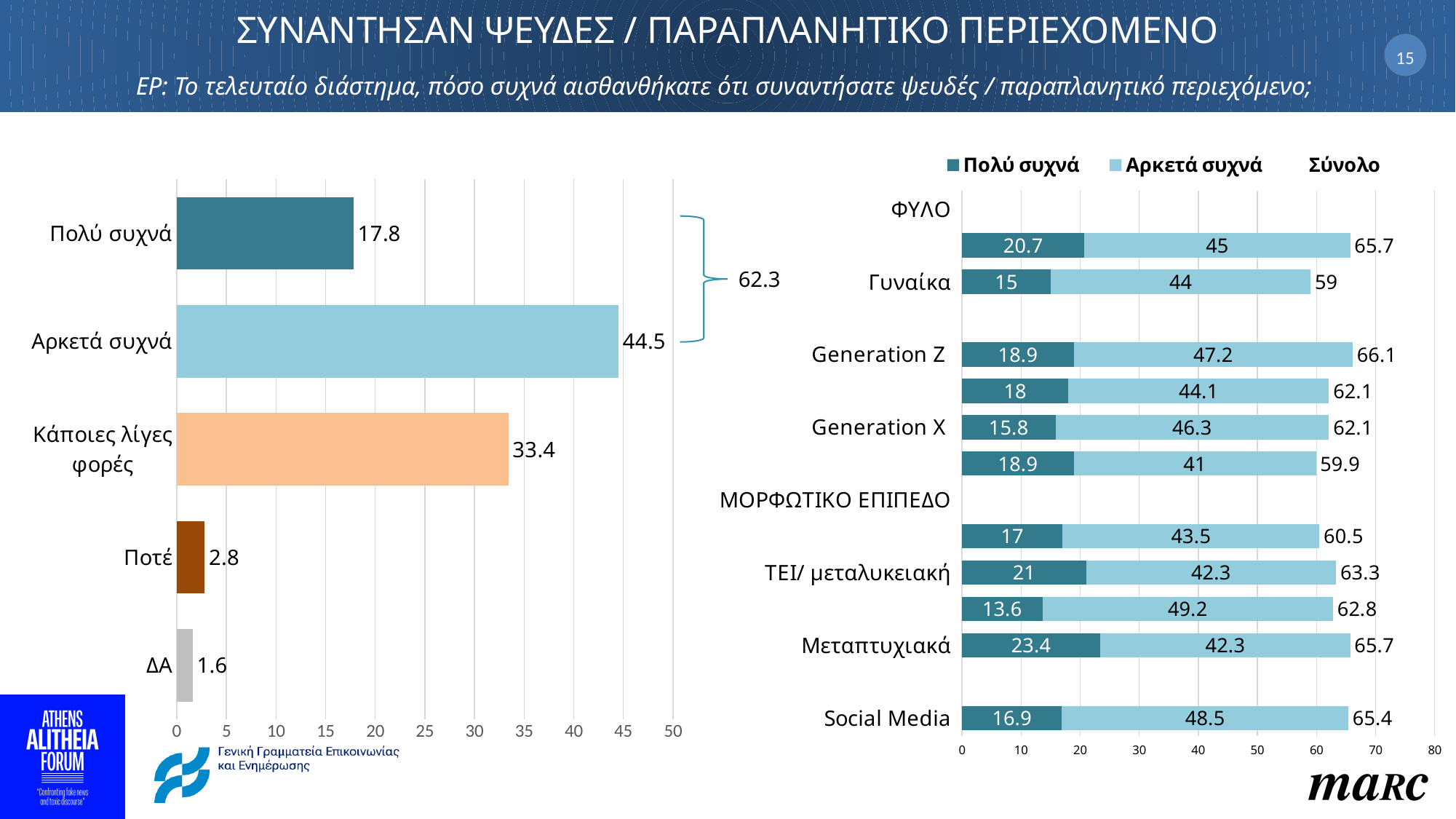
In the left chart, which category has the lowest value? ΔΑ In the right chart, what is the total (Σύνολο) for Generation Z? 66.1 In the left chart, which category has the highest value? Αρκετά συχνά In the left chart, how many categories are shown? 5 How many series does the legend of the right chart list? 3 What type of chart is the left chart? Bar chart In the right chart, which is larger: the Πολύ συχνά value for Γυναίκα or for Generation X? Generation X In the left chart, what is the difference between Αρκετά συχνά and Κάποιες λίγες φορές? 11.1 In the right chart, what is the Αρκετά συχνά value for Social Media? 48.5 In the right chart, what is the Πολύ συχνά value for Μεταπτυχιακά? 23.4 In the left chart, what is the value for Ποτέ? 2.8 In the left chart, what is the value for Αρκετά συχνά? 44.5